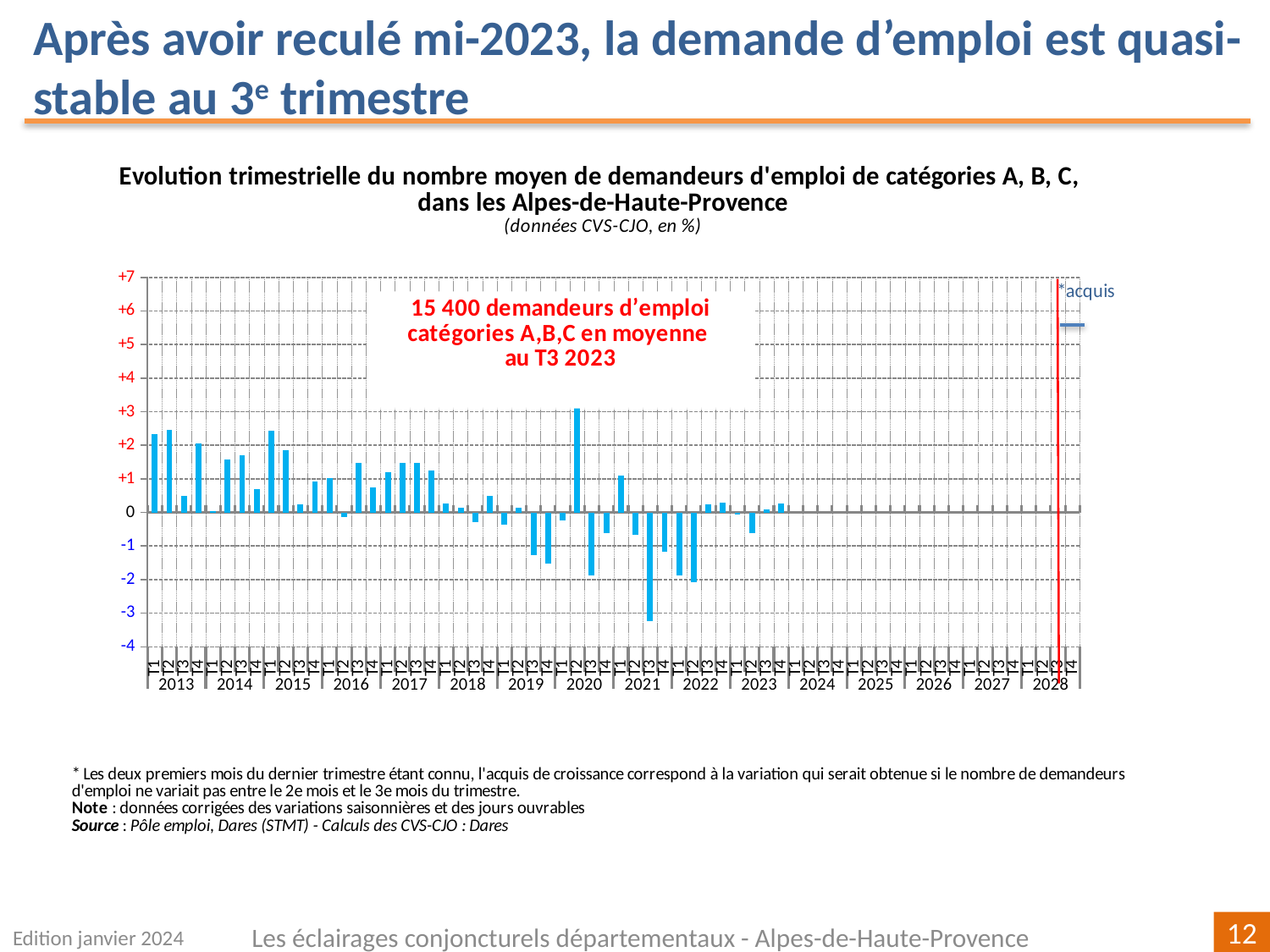
Is the value for T3 2021 greater or less than -3? less Which quarter has the lowest value on the chart? T3 2021 What kind of chart is shown on the slide? Bar chart Is the value for T1 2013 greater or less than +1? greater According to the annotation on the chart, how many demandeurs d'emploi of categories A, B, C were there on average in T3 2023? 15 400 In what unit are the values on the chart expressed, according to the subtitle? % Is the value for T2 2020 greater or less than +2? greater Which quarter has the highest value on the chart? T2 2020 Which is larger, the value for T2 2020 or the value for T1 2015? T2 2020 Which is larger, the value for T2 2013 or the value for T3 2013? T2 2013